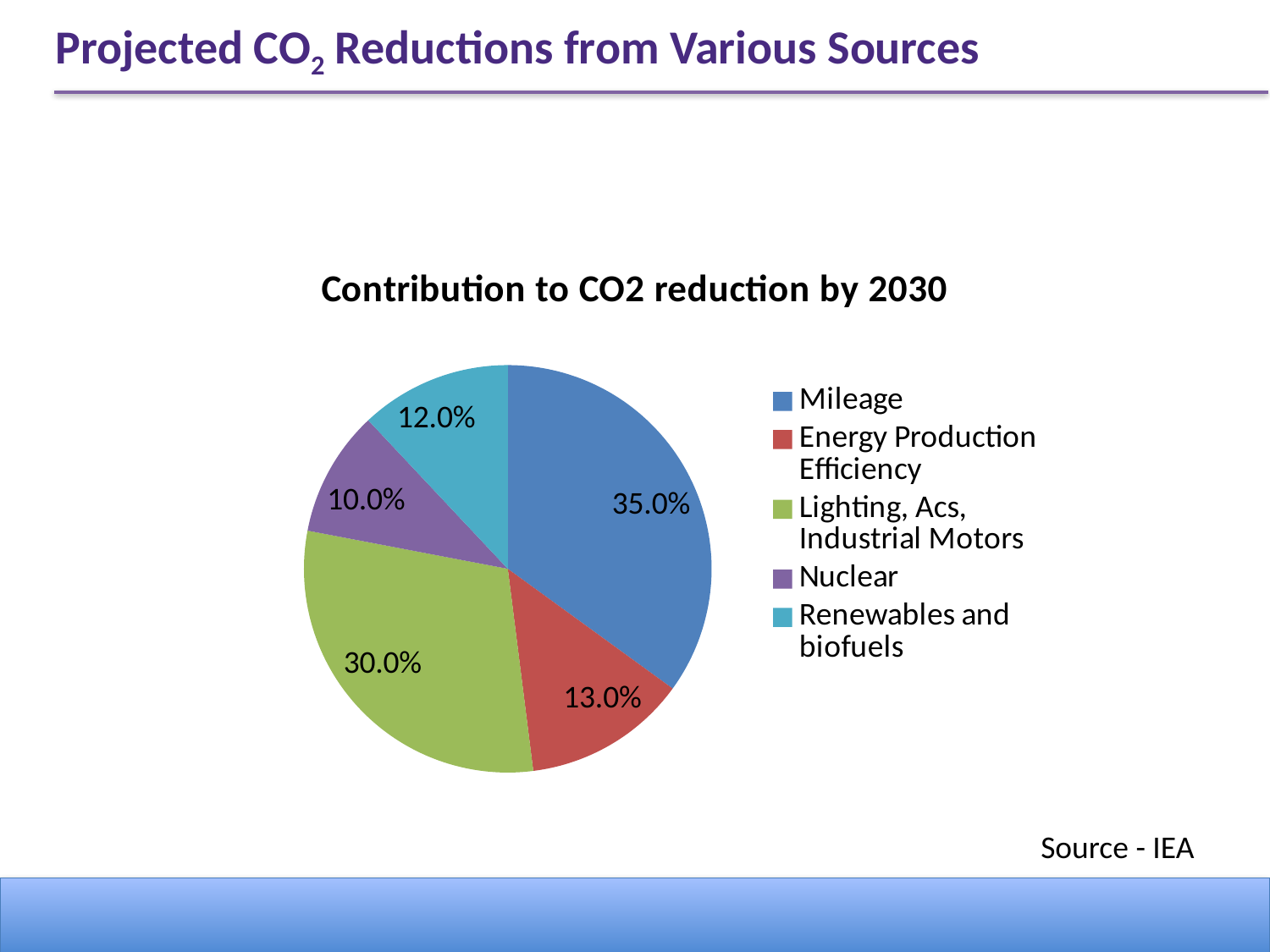
What is the difference between the Mileage and Lighting, Acs, Industrial Motors shares? 5.0% What is the value shown for Renewables and biofuels? 12.0% What is the value shown for Nuclear? 10.0% Which category has the largest slice of the pie? Mileage Which is larger, the share for Renewables and biofuels or the share for Nuclear? Renewables and biofuels Which category has the smallest slice of the pie? Nuclear What is the value shown for Lighting, Acs, Industrial Motors? 30.0% How many categories does the legend list? 5 What is the title of the chart? Contribution to CO2 reduction by 2030 What is the value shown for Energy Production Efficiency? 13.0% What share of the pie does Mileage account for? 35.0% What kind of chart is shown on the slide? pie chart